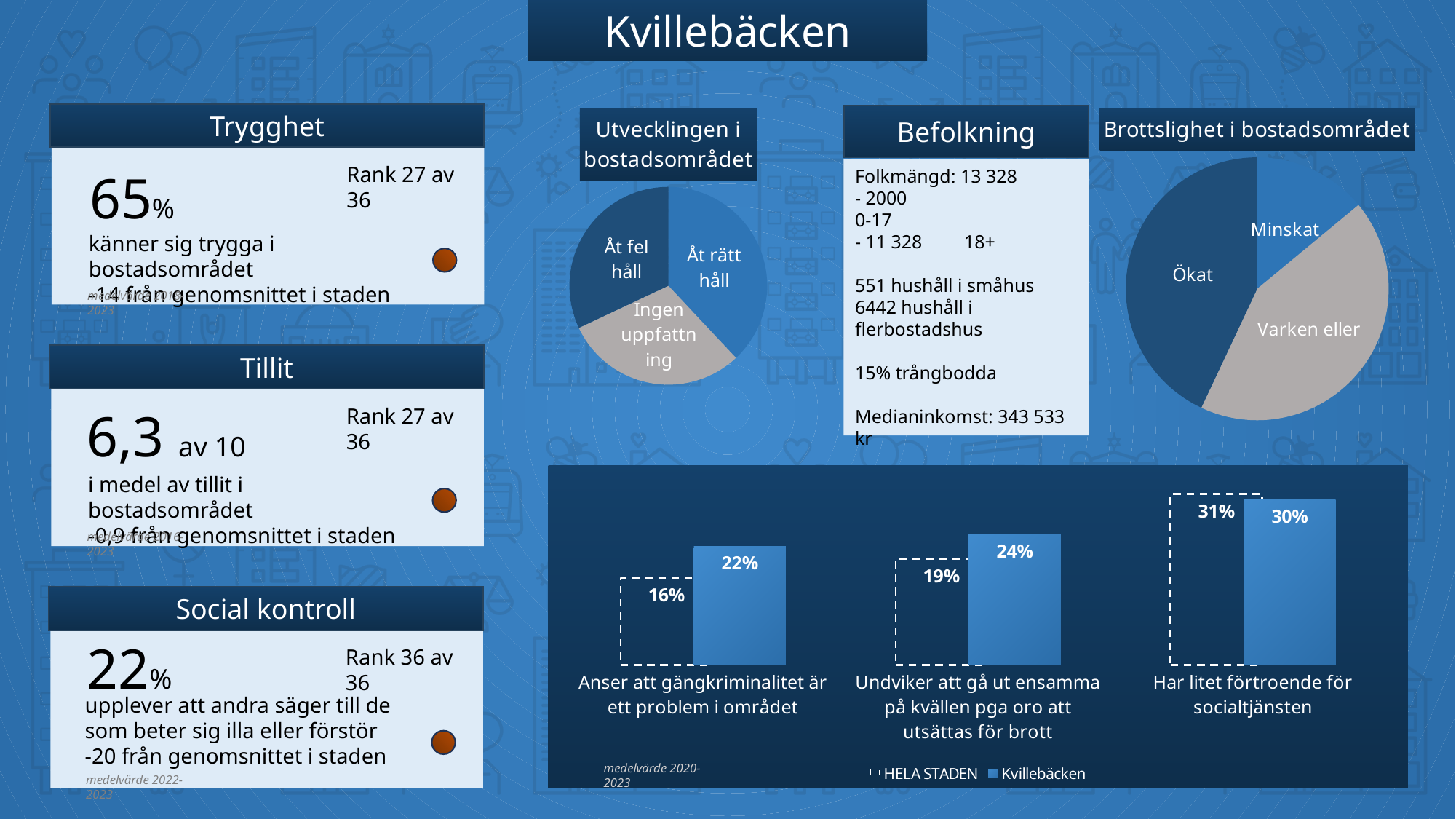
In the bottom bar chart, for 'Har litet förtroende för socialtjänsten', which is larger: HELA STADEN or Kvillebäcken? HELA STADEN In the bottom bar chart, what is the Kvillebäcken value for 'Anser att gängkriminalitet är ett problem i området'? 22% In the bottom bar chart, which category has the lowest HELA STADEN value? Anser att gängkriminalitet är ett problem i området How many slices does the 'Utvecklingen i bostadsområdet' pie chart have? 3 In the 'Brottslighet i bostadsområdet' pie chart, which slice is the smallest? Minskat How many categories are shown in the bottom bar chart? 3 In the bottom bar chart, what is the difference between the Kvillebäcken and HELA STADEN values for 'Anser att gängkriminalitet är ett problem i området'? 6% What kind of chart is 'Utvecklingen i bostadsområdet'? Pie chart In the bottom bar chart, what is the HELA STADEN value for 'Undviker att gå ut ensamma på kvällen pga oro att utsättas för brott'? 19% In the bottom bar chart, what is the HELA STADEN value for 'Har litet förtroende för socialtjänsten'? 31% How many series does the legend of the bottom bar chart list? 2 In the bottom bar chart, which category has the highest Kvillebäcken value? Har litet förtroende för socialtjänsten